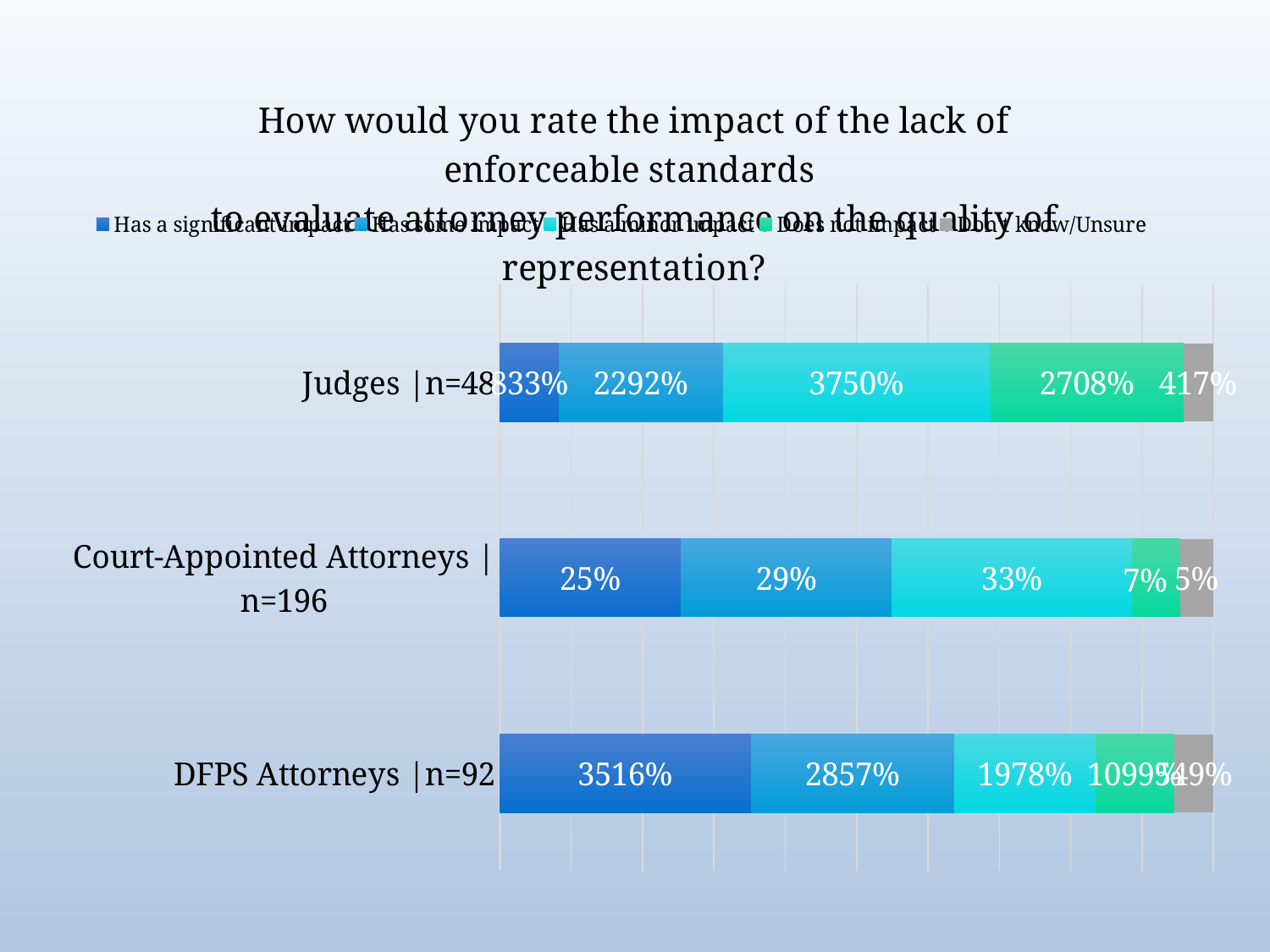
What is the value of the first (dark blue) segment of the Court-Appointed Attorneys | n=196 bar? 25% Which category on the chart has a sample size of n=196? Court-Appointed Attorneys Which segment of the Court-Appointed Attorneys | n=196 bar has the highest value? the third (cyan) segment, 33% How many series does the chart's legend list? 5 What label is printed on the first (dark blue) segment of the DFPS Attorneys | n=92 bar? 3516% What label is printed on the third (cyan) segment of the Judges | n=48 bar? 3750% What is the total of the five labelled segments in the Court-Appointed Attorneys | n=196 bar? 99% What is the value of the last (gray, Don't know/Unsure) segment of the Court-Appointed Attorneys | n=196 bar? 5% How many respondent groups (categories) are plotted on the chart? 3 What is the difference between the third segment (33%) and the first segment (25%) of the Court-Appointed Attorneys | n=196 bar? 8% What kind of chart is shown on the slide? bar chart In the Court-Appointed Attorneys | n=196 bar, which is larger: the second segment (29%) or the third segment (33%)? the third segment (33%)